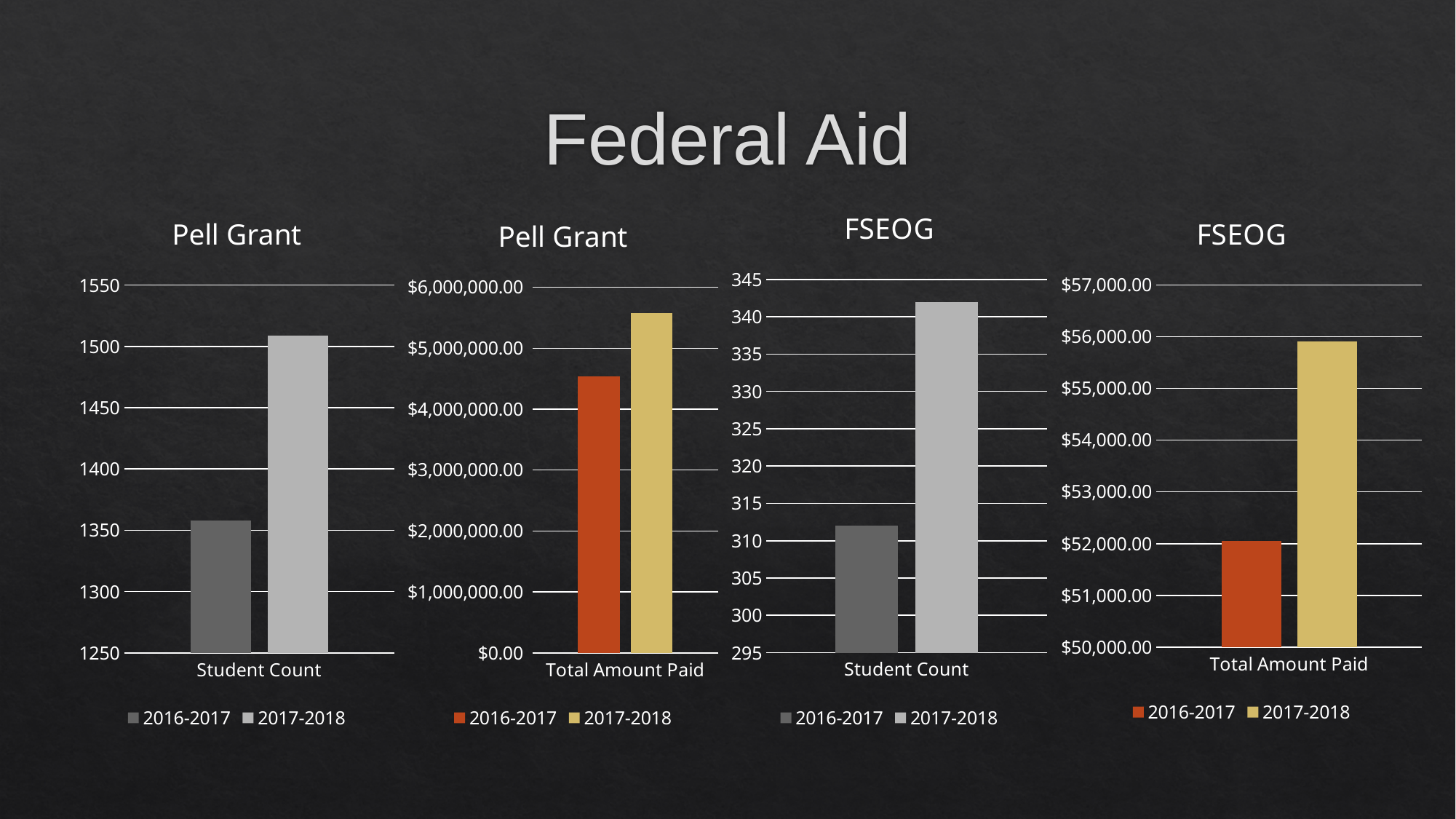
On the third chart from the left (FSEOG, Student Count), is the value for 2016-2017 greater or less than 315? less On the third chart from the left (FSEOG, Student Count), is the value for 2017-2018 greater or less than 335? greater On the second chart from the left (Pell Grant, Total Amount Paid), is the value for 2017-2018 greater or less than $5,000,000.00? greater How many series does the legend of the rightmost chart (FSEOG, Total Amount Paid) list? 2 On the third chart from the left (FSEOG, Student Count), which series has the lower value? 2016-2017 On the leftmost chart (Pell Grant, Student Count), which series has the higher value, 2016-2017 or 2017-2018? 2017-2018 What kind of chart is the leftmost chart (Pell Grant, Student Count)? bar chart On the rightmost chart (FSEOG, Total Amount Paid), which series has the higher value? 2017-2018